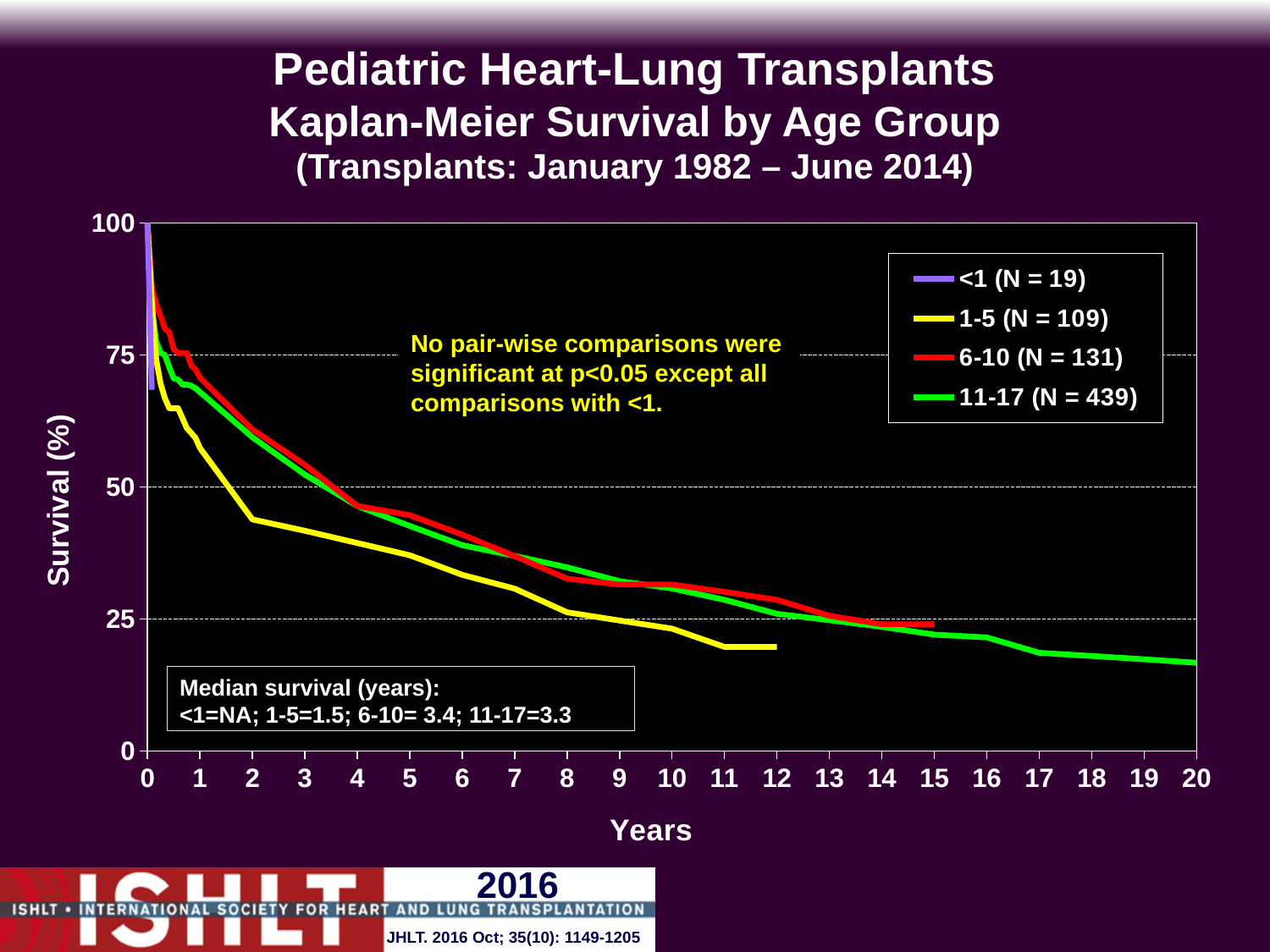
Which age group has the largest N in the legend? 11-17 Is the survival for the 1-5 group at year 2 greater or less than 50? less What kind of chart is shown on the slide? line chart What is the median survival in years for the 6-10 age group? 3.4 What is the median survival in years for the 1-5 age group? 1.5 Is the survival for the 11-17 group at year 20 greater or less than 25? less How many age groups (series) does the legend list? 4 What is the N for the 11-17 age group shown in the legend? 439 At year 2, which group has higher survival, 6-10 or 1-5? 6-10 Which age group has the smallest N in the legend? <1 What is the difference in N between the 11-17 group and the 6-10 group? 308 Do the survival curves rise or fall as years increase? fall